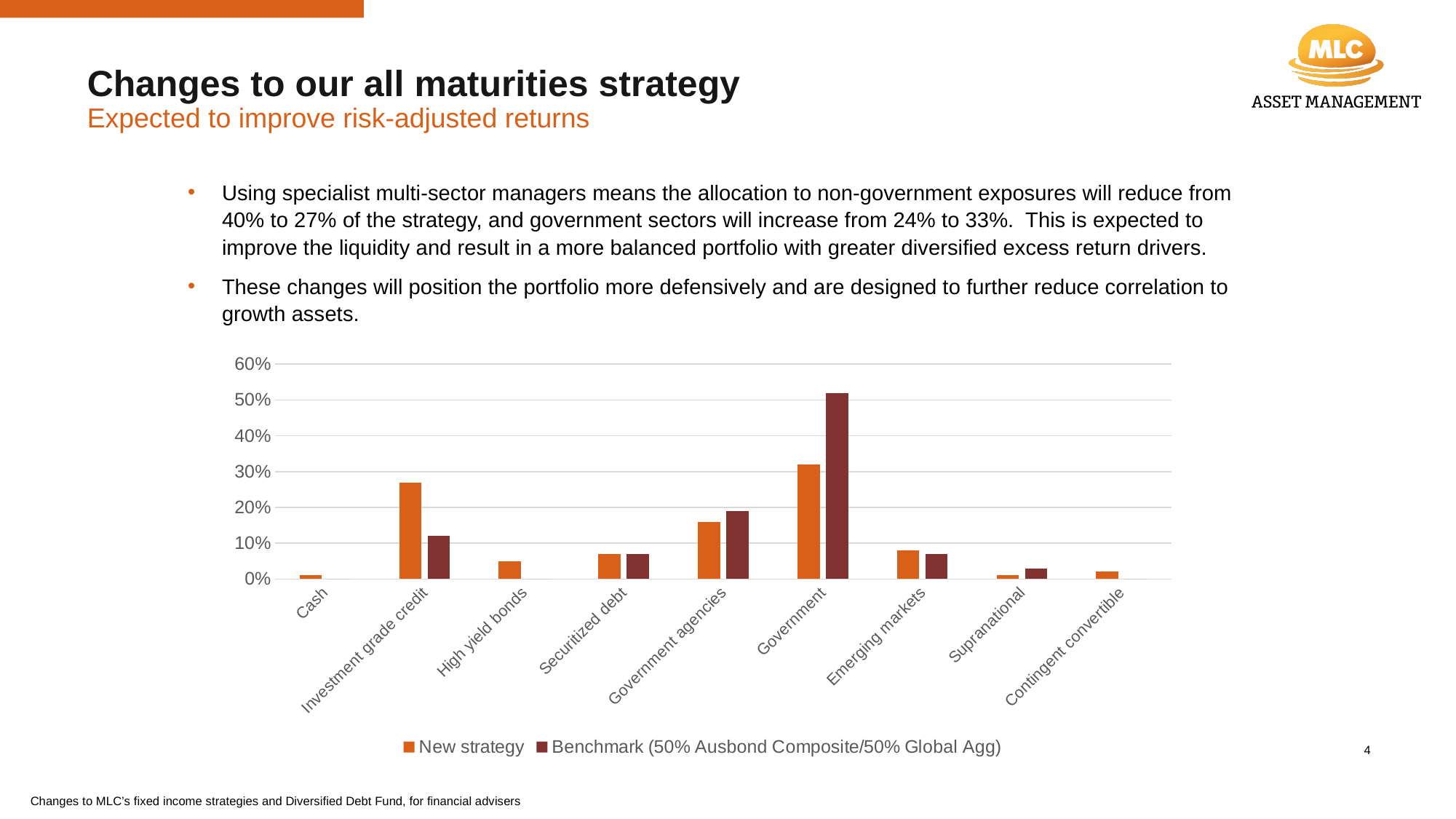
What is the name of the second series listed in the chart legend? Benchmark (50% Ausbond Composite/50% Global Agg) Is the New strategy value for Investment grade credit greater or less than 20%? greater Is the New strategy value for Government greater or less than 40%? less What kind of chart is shown on the slide? Bar chart For Government, which series has the larger value, New strategy or Benchmark? Benchmark (50% Ausbond Composite/50% Global Agg) Is the Benchmark value for Government greater or less than 50%? greater Which category has the highest Benchmark (50% Ausbond Composite/50% Global Agg) value? Government How many series does the chart legend list? 2 For Investment grade credit, which series has the larger value, New strategy or Benchmark? New strategy How many categories are shown on the x axis of the chart? 9 Which category has the highest New strategy value? Government